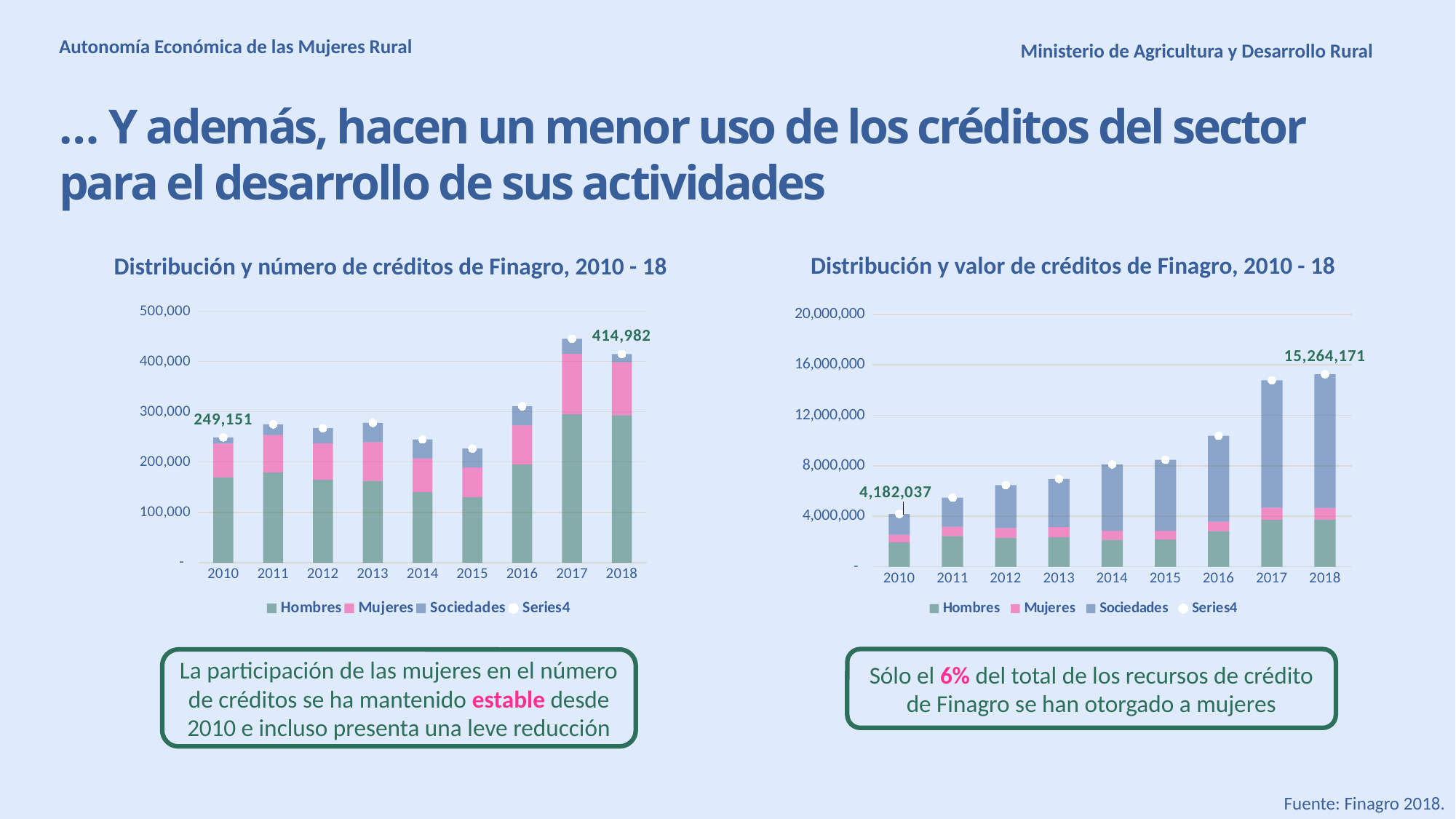
In the chart titled 'Distribución y número de créditos de Finagro, 2010 - 18', what is the difference between the labelled totals for 2018 and 2010? 165,831 In the chart titled 'Distribución y número de créditos de Finagro, 2010 - 18', what is the total value labelled for 2010? 249,151 How many years are shown on the x axis of the chart titled 'Distribución y número de créditos de Finagro, 2010 - 18'? 9 In the chart titled 'Distribución y valor de créditos de Finagro, 2010 - 18', is the total for 2016 greater or less than 8,000,000? greater How many series does the legend of the chart titled 'Distribución y valor de créditos de Finagro, 2010 - 18' list? 4 In the chart titled 'Distribución y número de créditos de Finagro, 2010 - 18', what is the total value labelled for 2018? 414,982 In the chart titled 'Distribución y valor de créditos de Finagro, 2010 - 18', what is the total value labelled for 2010? 4,182,037 In the chart titled 'Distribución y número de créditos de Finagro, 2010 - 18', which year has the highest total? 2017 What kind of chart is the chart titled 'Distribución y valor de créditos de Finagro, 2010 - 18'? Stacked bar chart In the chart titled 'Distribución y valor de créditos de Finagro, 2010 - 18', which year has the lowest total? 2010 In the chart titled 'Distribución y valor de créditos de Finagro, 2010 - 18', what is the total value labelled for 2018? 15,264,171 In the chart titled 'Distribución y valor de créditos de Finagro, 2010 - 18', what is the difference between the labelled totals for 2018 and 2010? 11,082,134